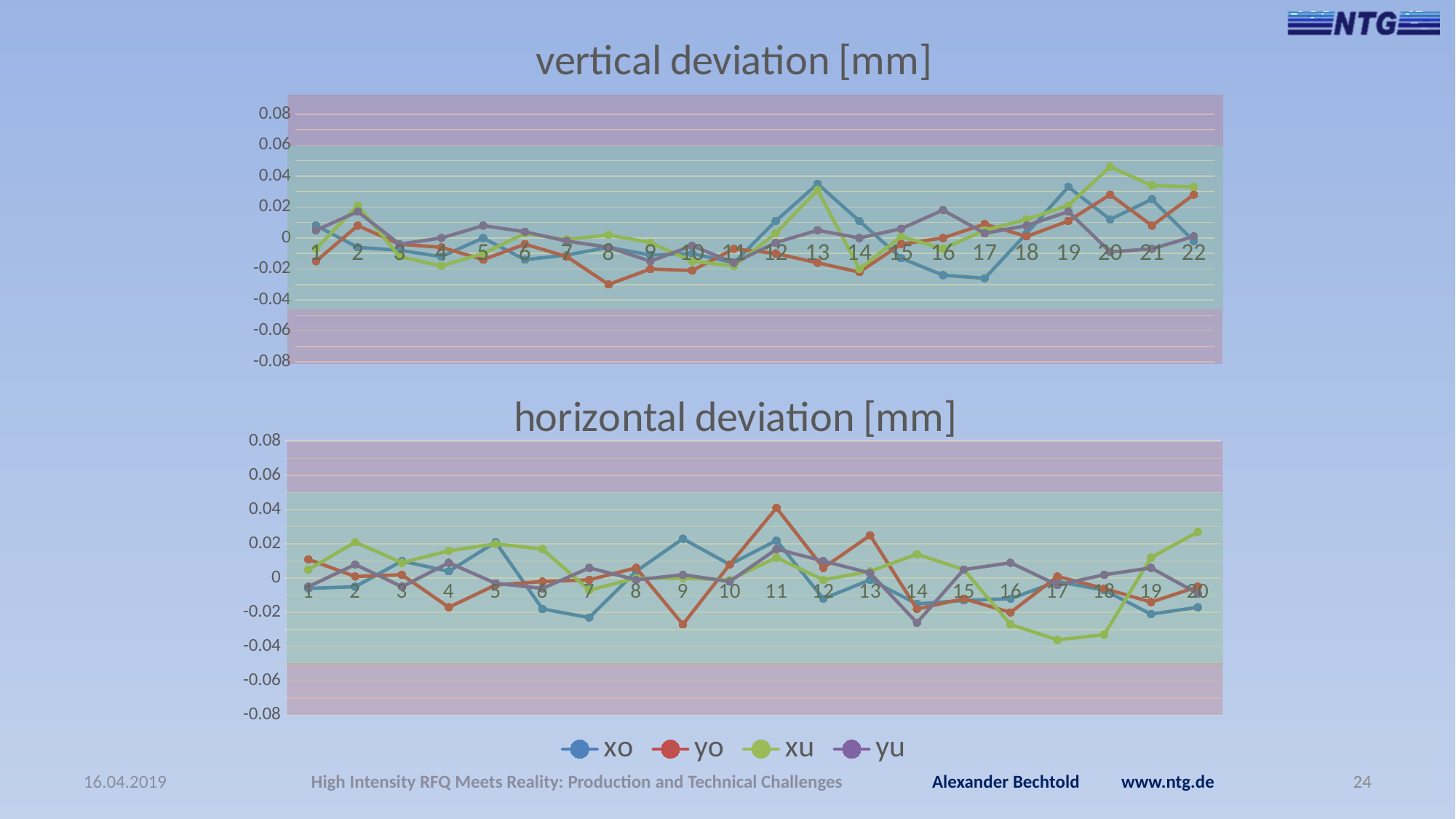
In the 'horizontal deviation [mm]' chart, is the value of yo at point 9 greater or less than 0? less In the 'horizontal deviation [mm]' chart, which series reaches the lowest value? xu What are the names of the four series in the legend? xo, yo, xu, yu How many points are plotted along the x axis of the 'vertical deviation [mm]' chart? 22 In the 'vertical deviation [mm]' chart, which series reaches the highest value? xu In the 'vertical deviation [mm]' chart, is the value of yo at point 8 greater or less than -0.02? less In the 'horizontal deviation [mm]' chart, is the value of xu at point 17 greater or less than -0.02? less How many series does the legend list? 4 What type of chart is the 'vertical deviation [mm]' chart? line chart In the 'vertical deviation [mm]' chart, at point 13, which is larger: xo or yo? xo How many points are plotted along the x axis of the 'horizontal deviation [mm]' chart? 20